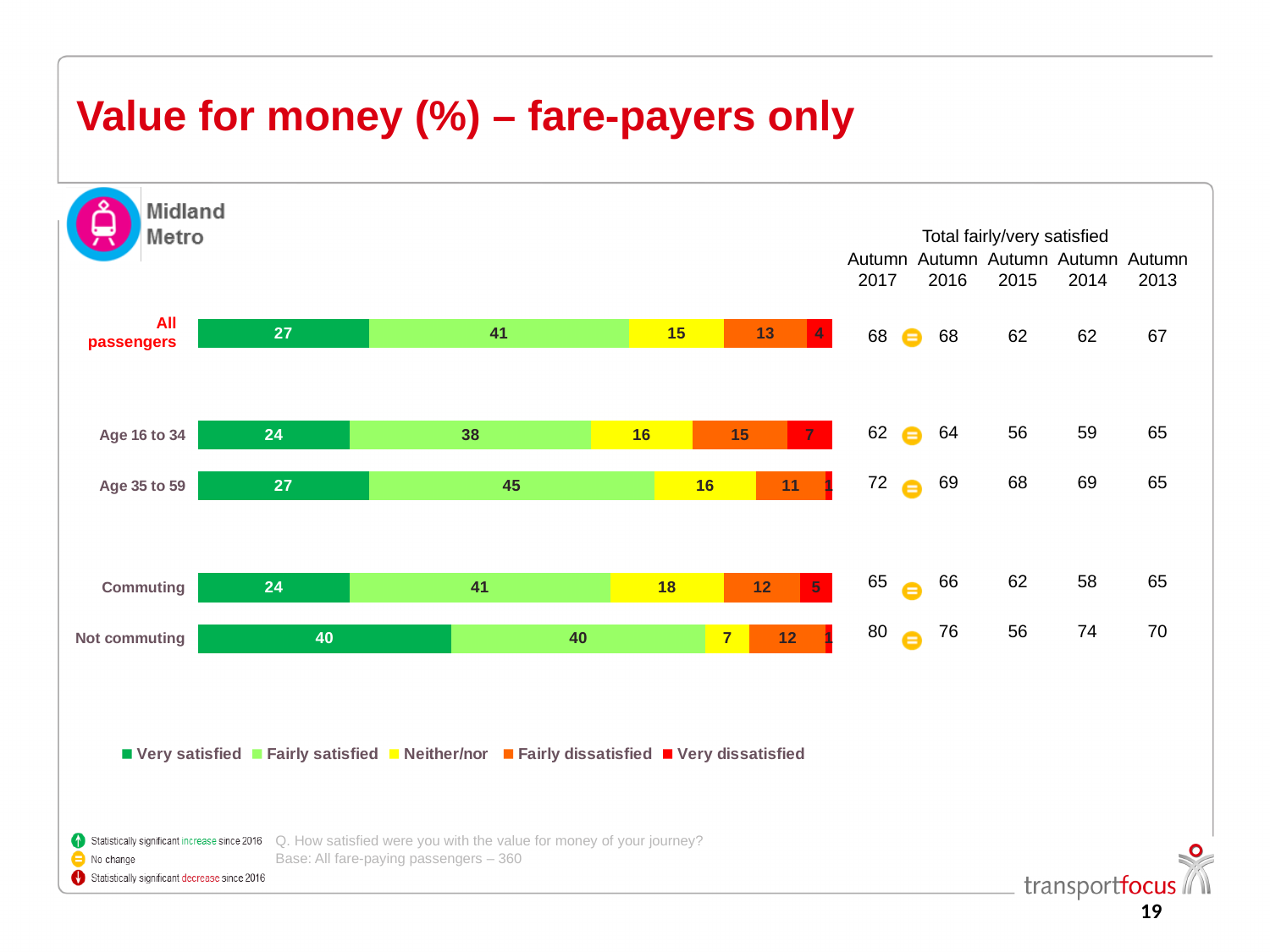
Which has the larger Very dissatisfied value, Age 16 to 34 or Commuting? Age 16 to 34 What is the difference between the Fairly satisfied values for Age 35 to 59 and Age 16 to 34? 7 How many categories are shown in the bar chart? 5 Which category has the highest Very satisfied value? Not commuting What is the first entry in the chart legend? Very satisfied How many series does the legend list? 5 What is the Fairly dissatisfied value for Age 16 to 34? 15 What is the total of the stacked bar for All passengers? 100 What is the Neither/nor value for Commuting? 18 What is the Very satisfied value for Not commuting? 40 Which category has the lowest Neither/nor value? Not commuting What kind of chart is shown on the slide? Stacked bar chart